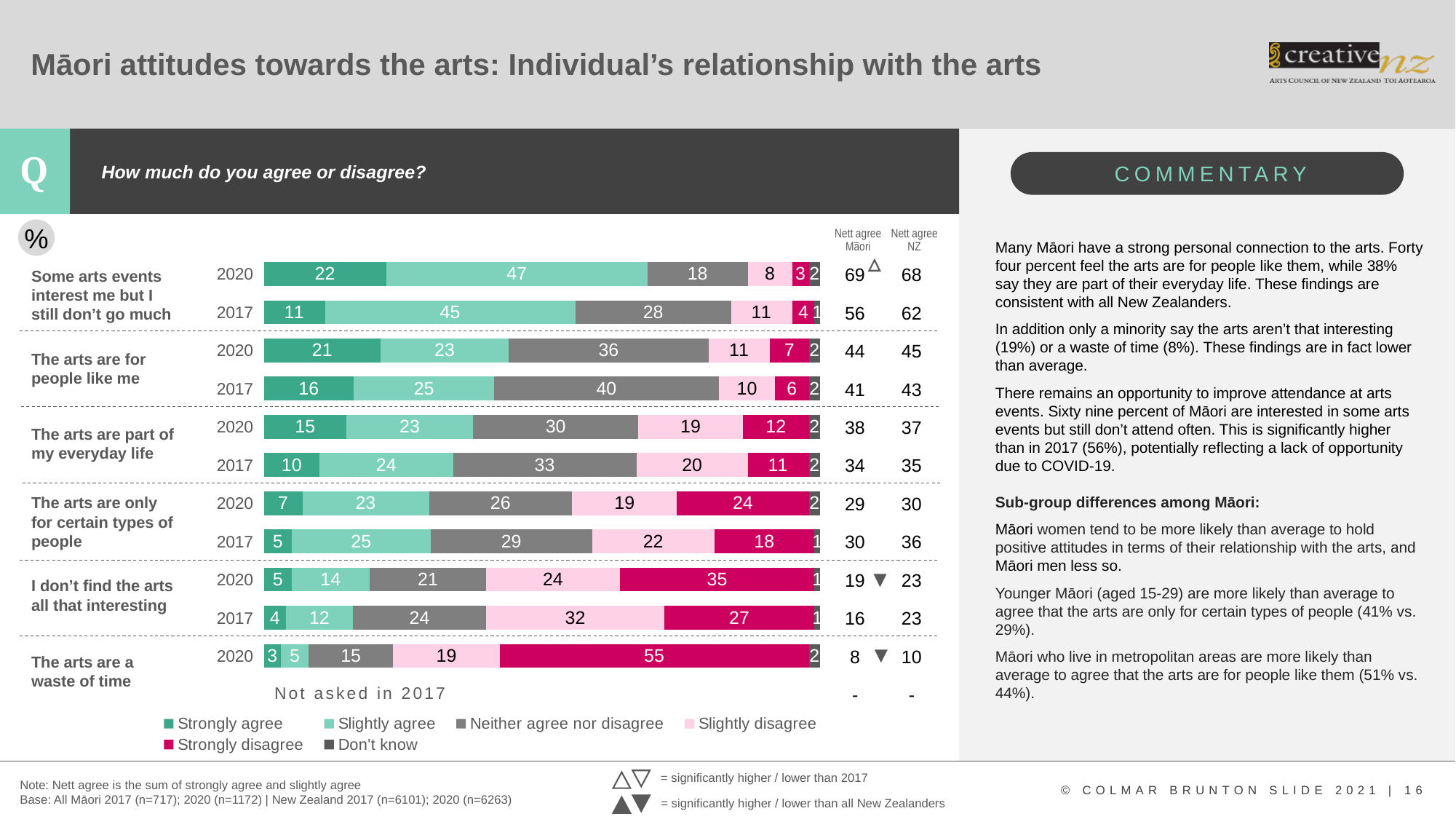
What is the 'Strongly agree' value for 'Some arts events interest me but I still don't go much' in 2020? 22 What is the difference between the Nett agree Māori figures for 'Some arts events interest me but I still don't go much' in 2020 and 2017? 13 What kind of chart is shown on the slide? Stacked bar chart How many series does the legend list? 6 What is the 'Strongly disagree' value for 'The arts are a waste of time' in 2020? 55 Which statement has the lowest Nett agree Māori figure in 2020? The arts are a waste of time What is the total of 'Strongly agree' and 'Slightly agree' for 'I don't find the arts all that interesting' in 2020? 19 Which statement has the highest 'Strongly disagree' value in 2020? The arts are a waste of time What is the Nett agree Māori figure for 'The arts are part of my everyday life' in 2020? 38 Which is larger: the 'Slightly agree' value for 'Some arts events interest me but I still don't go much' in 2020 or in 2017? 2020 Which statement is marked 'Not asked in 2017'? The arts are a waste of time What is the 'Neither agree nor disagree' value for 'The arts are for people like me' in 2017? 40